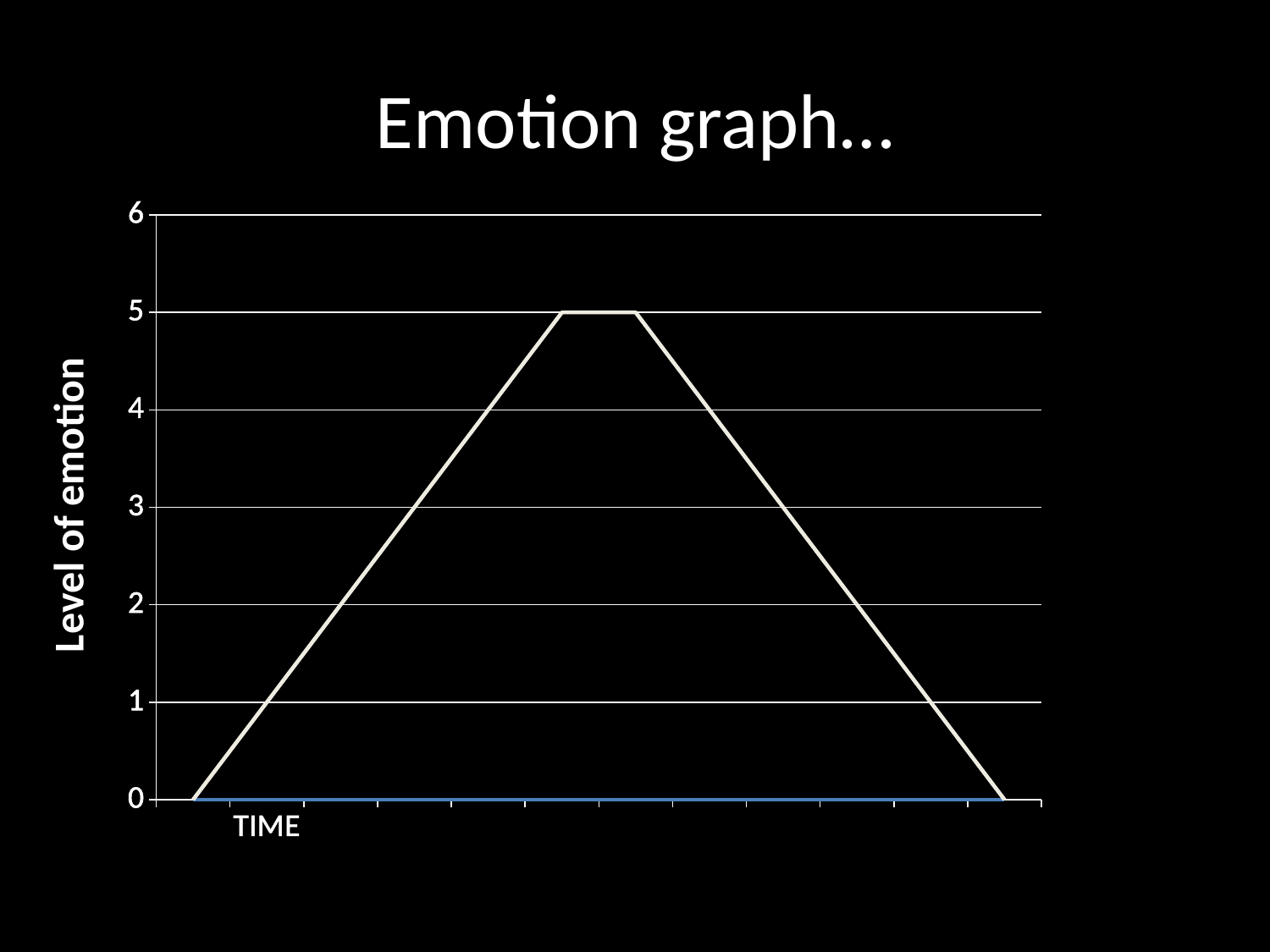
At what level of emotion does the line end at the end of the time axis? 0 What kind of chart is shown on the slide? line chart What is the title of the chart? Emotion graph... Does the line rise or fall over the first half of the time axis? rise What is the highest level of emotion reached by the line? 5 What is the highest tick value shown on the vertical axis? 6 Is the peak value of the line greater or less than 4? greater At what level of emotion does the line start at the beginning of the time axis? 0 Is the peak value of the line greater or less than 6? less What is the lowest level of emotion shown by the line? 0 What is the label on the vertical axis of the chart? Level of emotion Does the line rise or fall over the second half of the time axis? fall